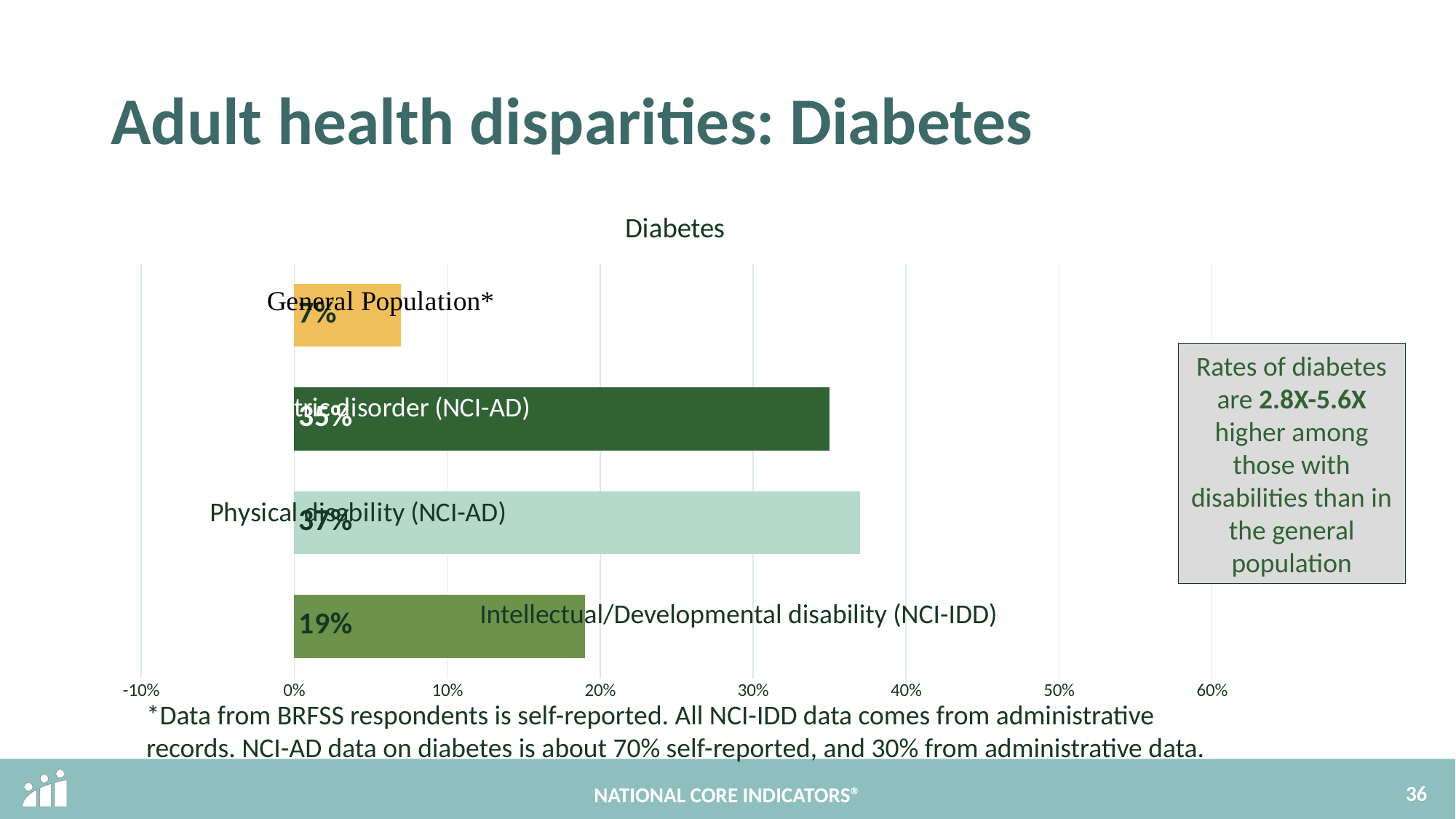
Which category has the lowest diabetes rate in the chart? General Population* How many percentage points higher is the Intellectual/Developmental disability (NCI-IDD) rate than the General Population* rate? 12 percentage points What is the diabetes rate shown for Intellectual/Developmental disability (NCI-IDD)? 19% What kind of chart is shown on the slide? Bar chart What value is labelled on the second bar from the top of the chart? 35% What is the diabetes rate shown for Physical disability (NCI-AD)? 37% What is the title of the chart? Diabetes Which is larger, the rate for Intellectual/Developmental disability (NCI-IDD) or the rate for Physical disability (NCI-AD)? Physical disability (NCI-AD) Which category has the highest diabetes rate in the chart? Physical disability (NCI-AD) How many bars are plotted in the chart? 4 What is the diabetes rate shown for the General Population* bar? 7% How many percentage points higher is the Physical disability (NCI-AD) rate than the General Population* rate? 30 percentage points